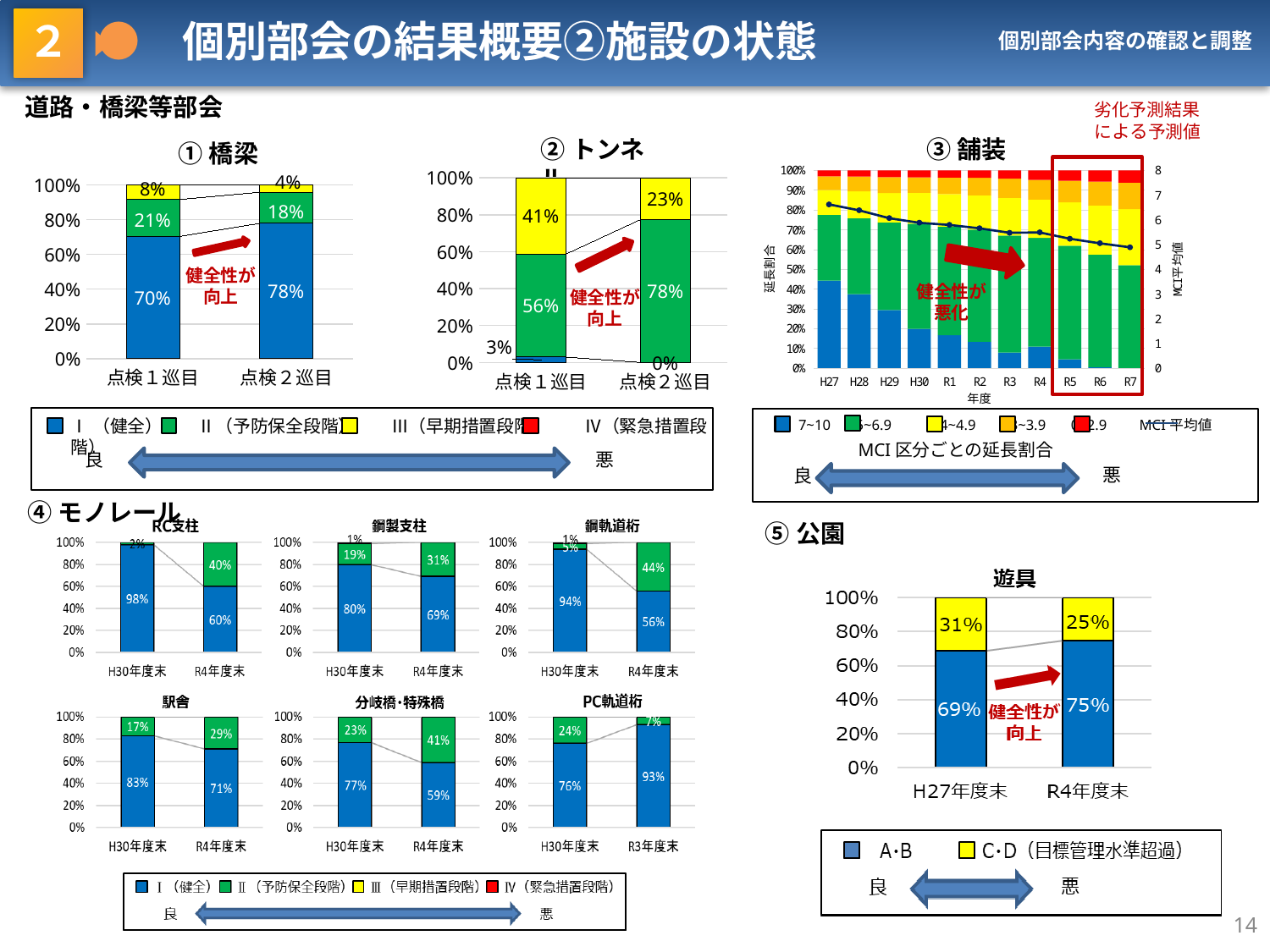
In the ① 橋梁 chart, what is the value of the I（健全） segment for 点検２巡目? 78% In the ③ 舗装 chart, does the MCI平均値 line rise or fall from H27 to R7? Falls In the ② トンネル chart, what is the value of the III（早期措置段階） segment for 点検１巡目? 41% In the ⑤ 公園 遊具 chart, what is the value of the C･D segment at H27年度末? 31% In the ① 橋梁 chart, by how many percentage points does the I（健全） segment increase from 点検１巡目 to 点検２巡目? 8 percentage points In the ② トンネル chart, which inspection round has the larger III（早期措置段階） segment, 点検１巡目 or 点検２巡目? 点検１巡目 How many fiscal-year categories are shown on the x axis of the ③ 舗装 chart? 11 In the ① 橋梁 chart, what is the value of the III（早期措置段階） segment for 点検１巡目? 8% What type of chart is the ⑤ 公園 遊具 chart? Stacked bar chart In the ② トンネル chart, what is the value of the II（予防保全段階） segment for 点検２巡目? 78% In the ④ モノレール PC軌道桁 chart, what is the value of the I（健全） segment at R3年度末? 93% In the ④ モノレール RC支柱 chart, what is the value of the I（健全） segment at R4年度末? 60%